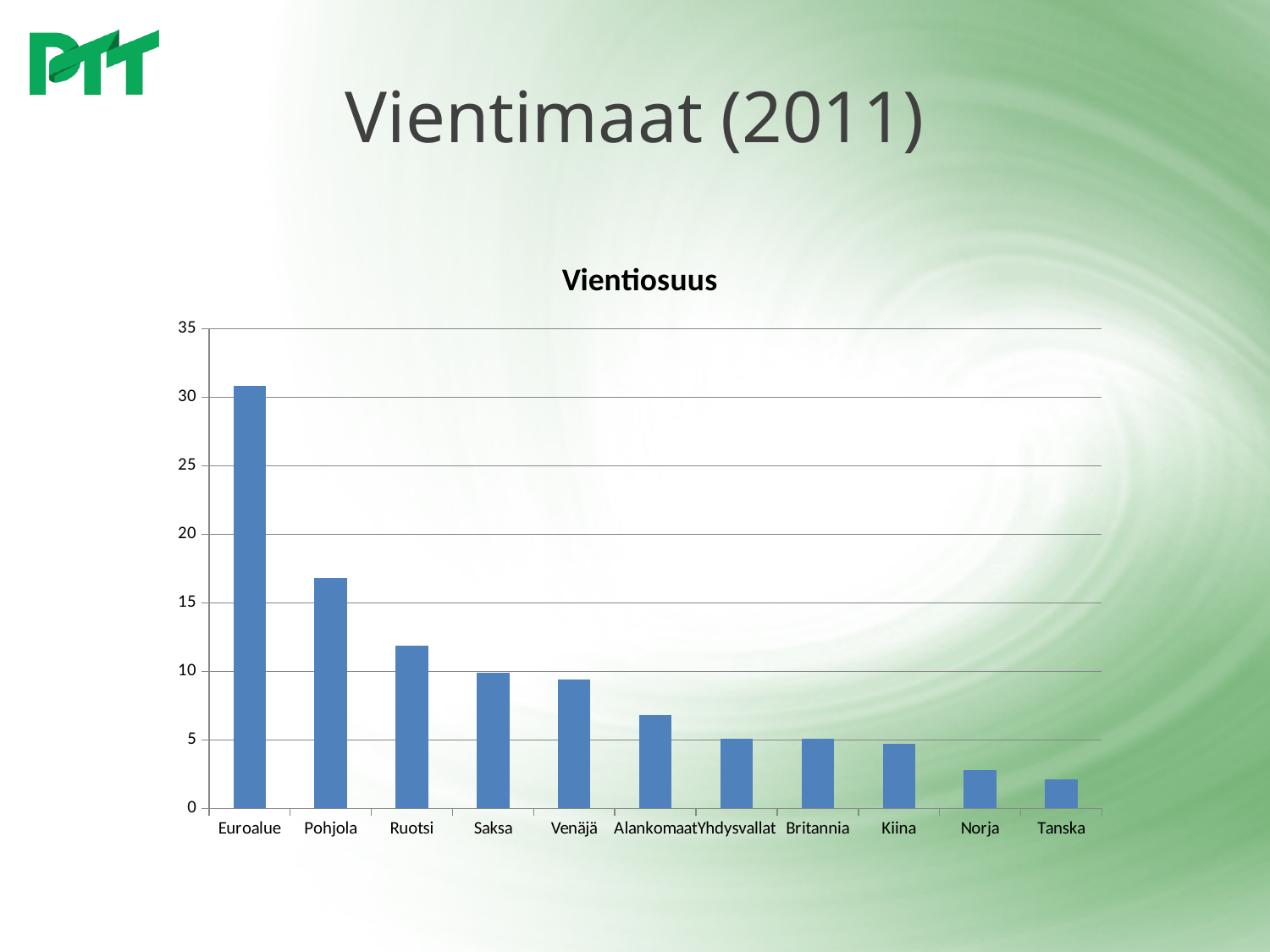
Is the value for Norja greater or less than 5? less Which category has the highest value in the chart? Euroalue Do the values rise or fall from left to right along the x axis? fall Is the value for Euroalue greater or less than 25? greater What is the title of the chart? Vientiosuus Which is larger, the value for Norja or the value for Tanska? Norja Is the value for Pohjola greater or less than 15? greater Which category has the lowest value in the chart? Tanska Which is larger, the value for Pohjola or the value for Ruotsi? Pohjola How many categories are shown on the x axis of the chart? 11 What kind of chart is shown on the slide? bar chart